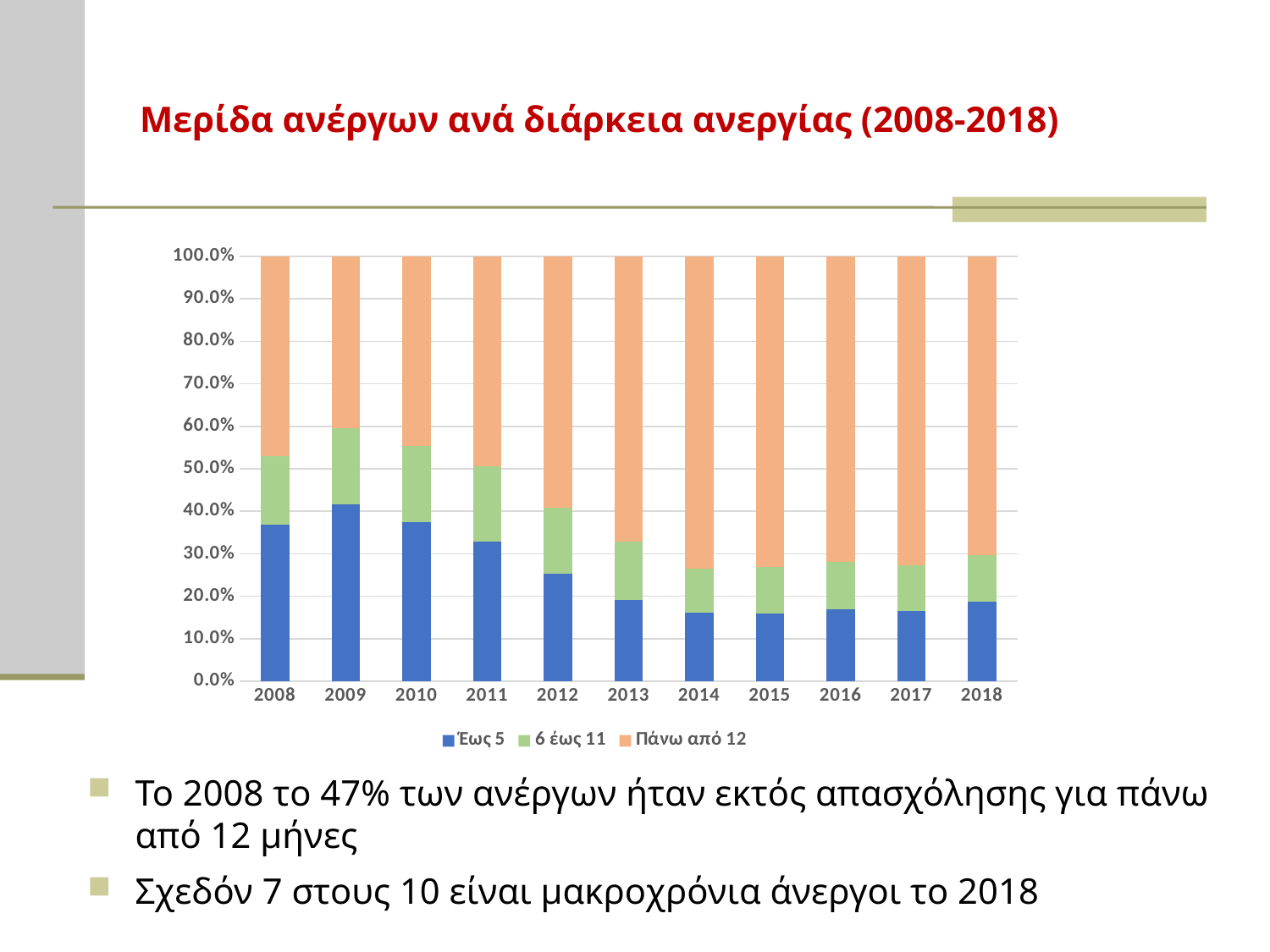
Which year has the highest share for the 'Έως 5' series? 2009 Is the 'Έως 5' share in 2014 greater or less than 20.0%? less What is the title of the slide containing the chart? Μερίδα ανέργων ανά διάρκεια ανεργίας (2008-2018) Which year has the larger 'Έως 5' share, 2008 or 2011? 2008 What kind of chart is shown on the slide? Stacked bar chart Which series is shown in orange in the chart? Πάνω από 12 Does the 'Έως 5' share rise or fall from 2009 to 2015? Fall How many years are shown on the x axis of the chart? 11 Is the 'Έως 5' share in 2009 greater or less than 40.0%? greater Is the 'Έως 5' share in 2008 greater or less than 40.0%? less How many series does the chart legend list? 3